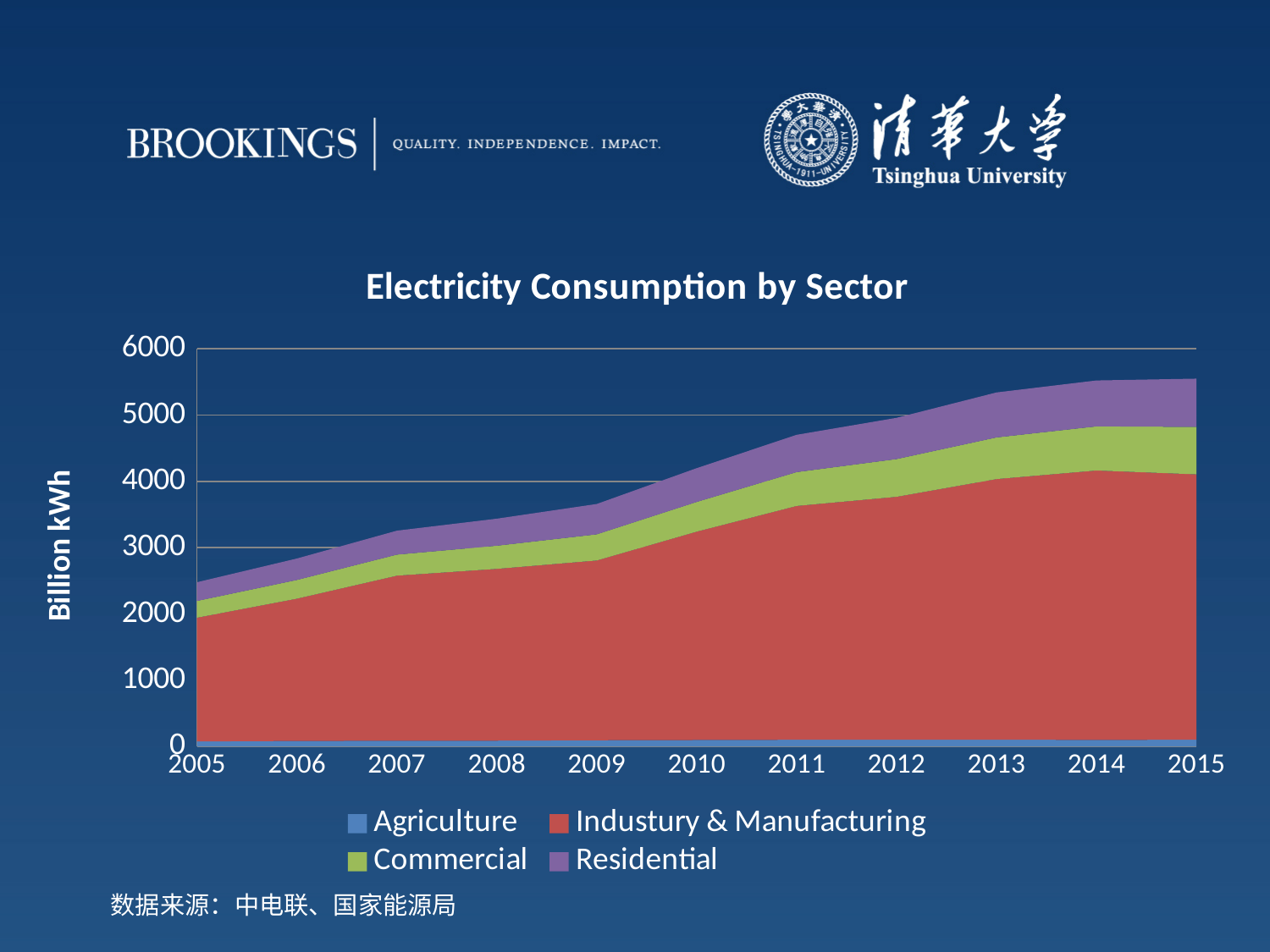
Does total electricity consumption rise or fall from 2005 to 2015? Rise How many series does the legend list? 4 Which sector accounts for the smallest share of electricity consumption? Agriculture How many years are shown along the x axis? 11 What kind of chart is shown on the slide? Stacked area chart Is the total electricity consumption in 2011 greater or less than 4000 billion kWh? greater Which sector accounts for the largest share of electricity consumption in every year shown? Industury & Manufacturing What is the label on the vertical axis? Billion kWh Is total electricity consumption larger in 2015 or in 2005? 2015 What is the title of the chart? Electricity Consumption by Sector Is the total electricity consumption in 2015 greater or less than 5000 billion kWh? greater Is the total electricity consumption in 2005 greater or less than 3000 billion kWh? less